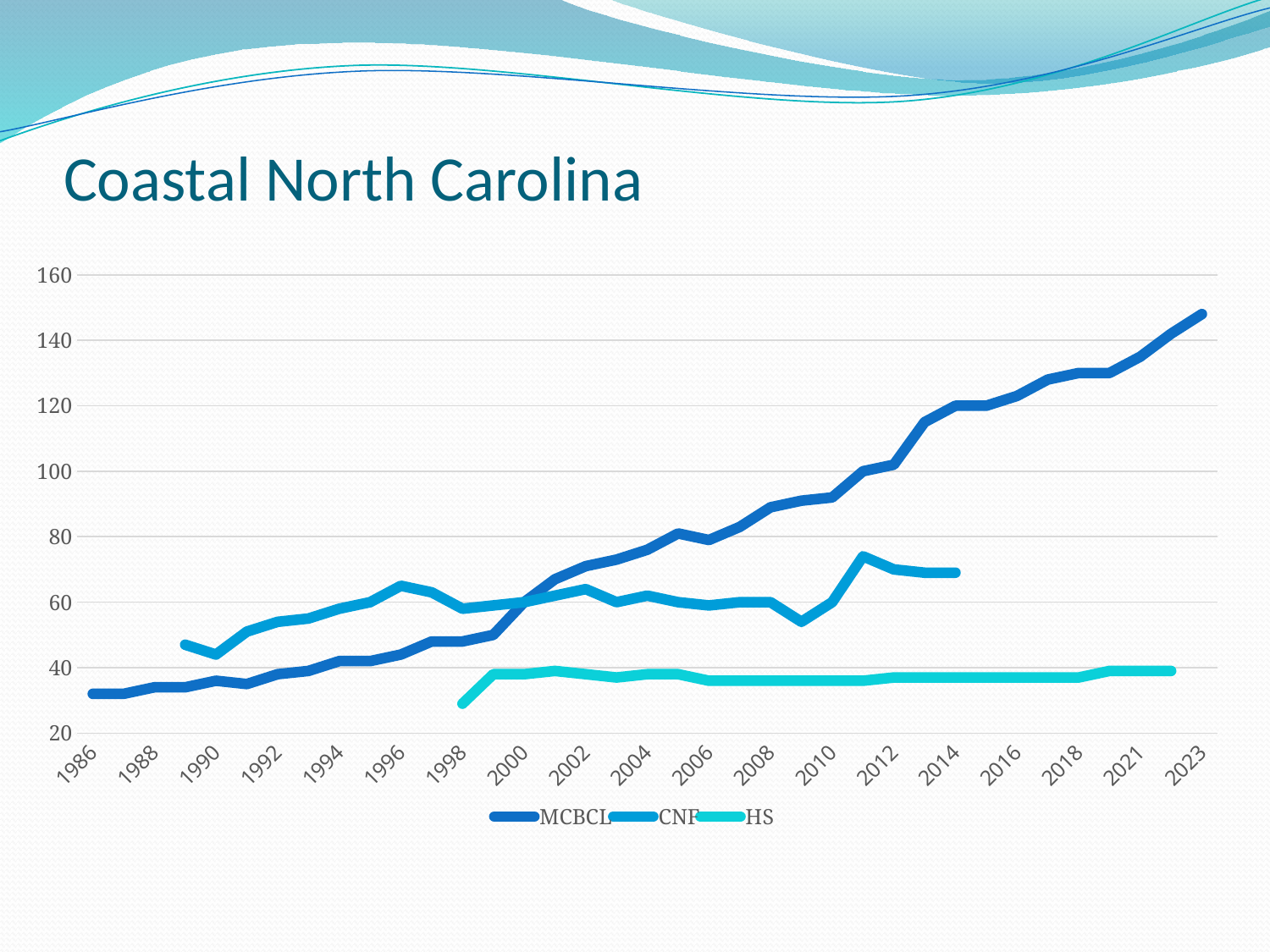
Is the value for MCBCL in 1986 greater or less than 40? less What kind of chart is shown on the slide? Line chart Is the value for CNF in 2014 greater or less than 60? greater Which series reaches the highest value on the chart? MCBCL Which series are listed in the legend? MCBCL, CNF, HS Is the value for HS in 1998 greater or less than 40? less In 2010, which series has the larger value, MCBCL or CNF? MCBCL How many series does the legend list? 3 Which series has the lowest values at the right end of the chart? HS What is the title of the chart? Coastal North Carolina Does the MCBCL line generally rise or fall from 1986 to 2023? Rise